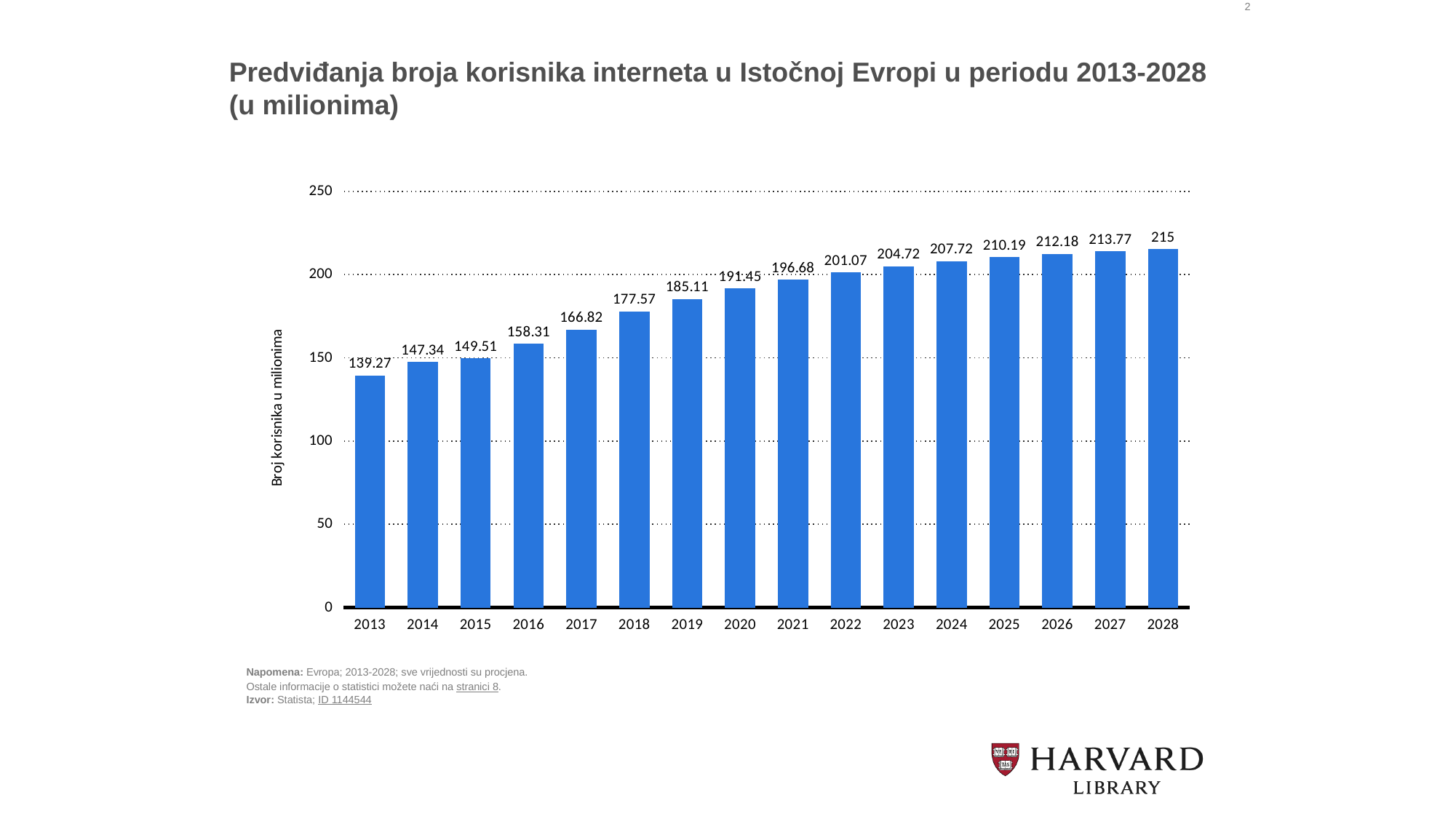
Do the values rise or fall from 2013 to 2028? rise Which is larger, the value for 2017 or the value for 2019? 2019 Is the value for 2022 greater or less than 200? greater What is the value for 2028? 215 What is the value for 2013? 139.27 Which year has the highest value? 2028 What is the difference between the values for 2028 and 2013? 75.73 What is the label of the y axis? Broj korisnika u milionima What kind of chart is this? bar chart How many years are shown on the x axis? 16 What is the value for 2020? 191.45 Which year has the lowest value? 2013